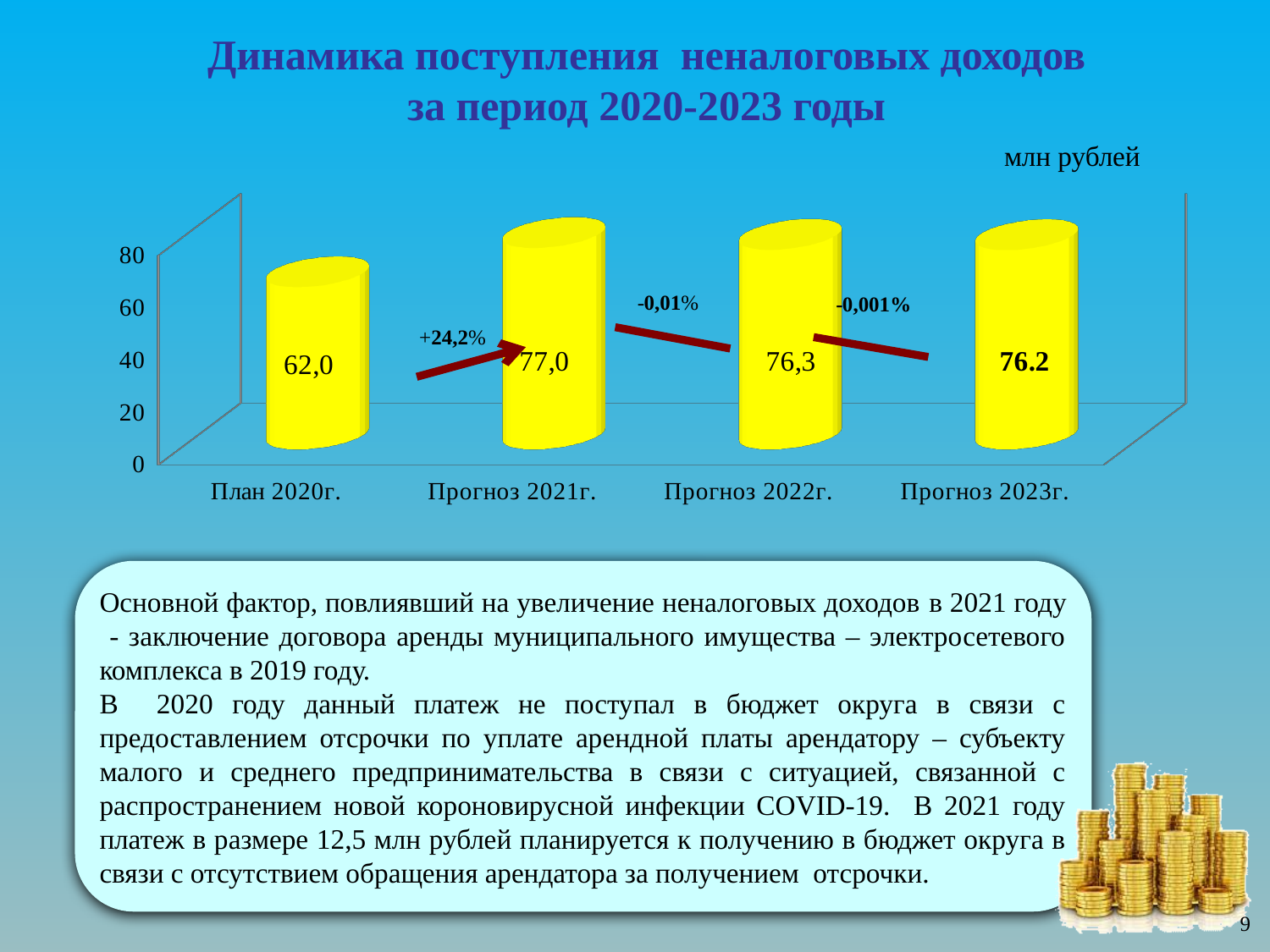
What is the value for План 2020г.? 62,0 What kind of chart is shown on the slide? bar chart Is the value for Прогноз 2021г. greater or less than 60? greater What is the value for Прогноз 2023г.? 76.2 Which is larger, the value for План 2020г. or the value for Прогноз 2022г.? Прогноз 2022г. What is the value for Прогноз 2022г.? 76,3 Which category has the lowest value? План 2020г. What is the difference between the values for Прогноз 2021г. and План 2020г.? 15,0 What unit of measurement is indicated above the chart? млн рублей How many categories are shown on the x axis? 4 Which category has the highest value? Прогноз 2021г. What is the value for Прогноз 2021г.? 77,0